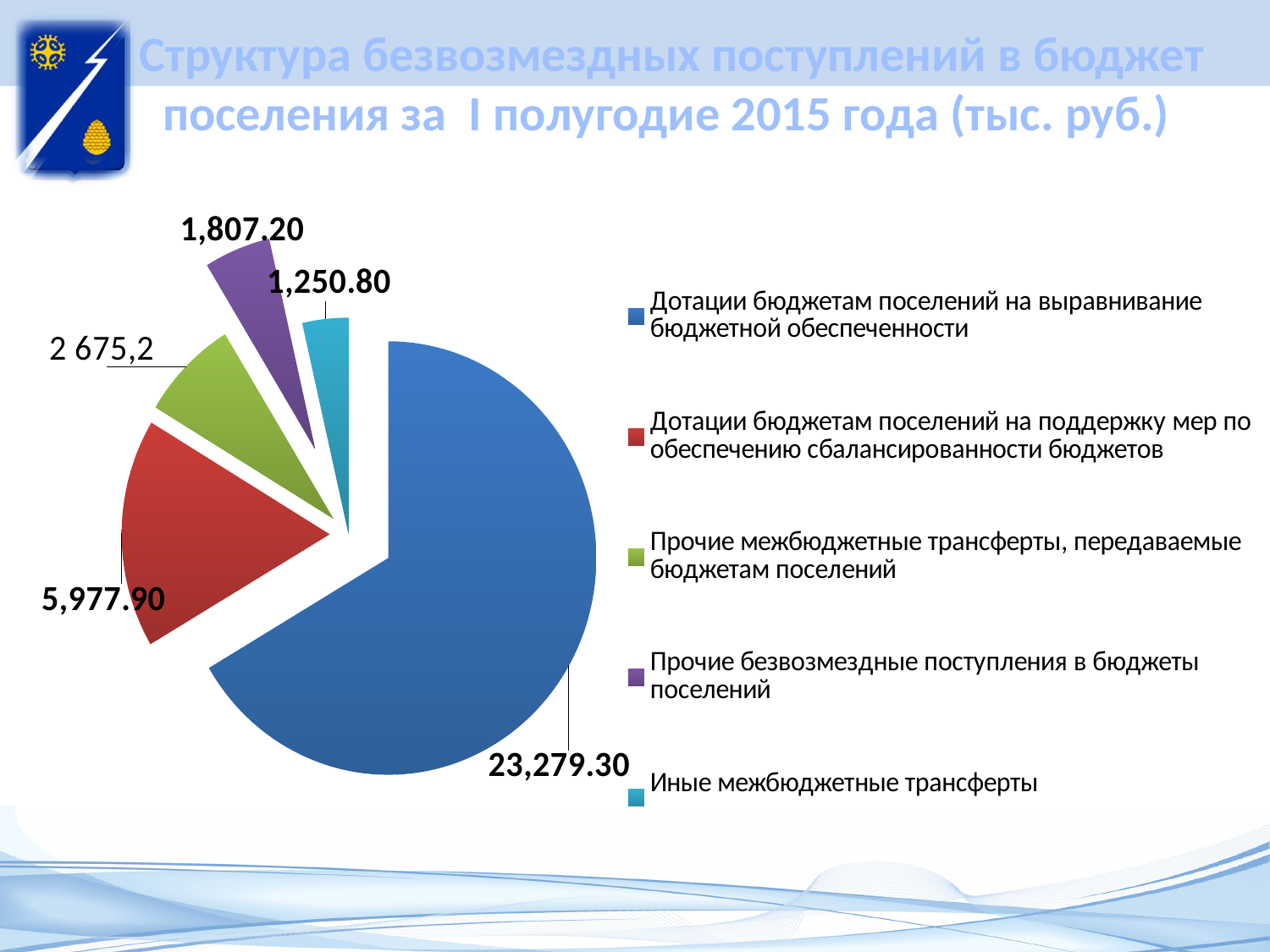
What is the value for «Дотации бюджетам поселений на поддержку мер по обеспечению сбалансированности бюджетов»? 5,977.90 What is the difference between the value for «Дотации бюджетам поселений на выравнивание бюджетной обеспеченности» and the value for «Дотации бюджетам поселений на поддержку мер по обеспечению сбалансированности бюджетов»? 17,301.40 How many slices does the pie chart have? 5 Which is larger: the value for «Прочие безвозмездные поступления в бюджеты поселений» or the value for «Иные межбюджетные трансферты»? Прочие безвозмездные поступления в бюджеты поселений How many entries does the legend list? 5 What is the value for «Прочие межбюджетные трансферты, передаваемые бюджетам поселений»? 2 675,2 Which category has the largest slice of the pie? Дотации бюджетам поселений на выравнивание бюджетной обеспеченности What is the value for «Дотации бюджетам поселений на выравнивание бюджетной обеспеченности»? 23,279.30 What type of chart is shown on the slide? pie chart What is the value for «Прочие безвозмездные поступления в бюджеты поселений»? 1,807.20 Which category has the smallest slice of the pie? Иные межбюджетные трансферты What is the value for «Иные межбюджетные трансферты»? 1,250.80